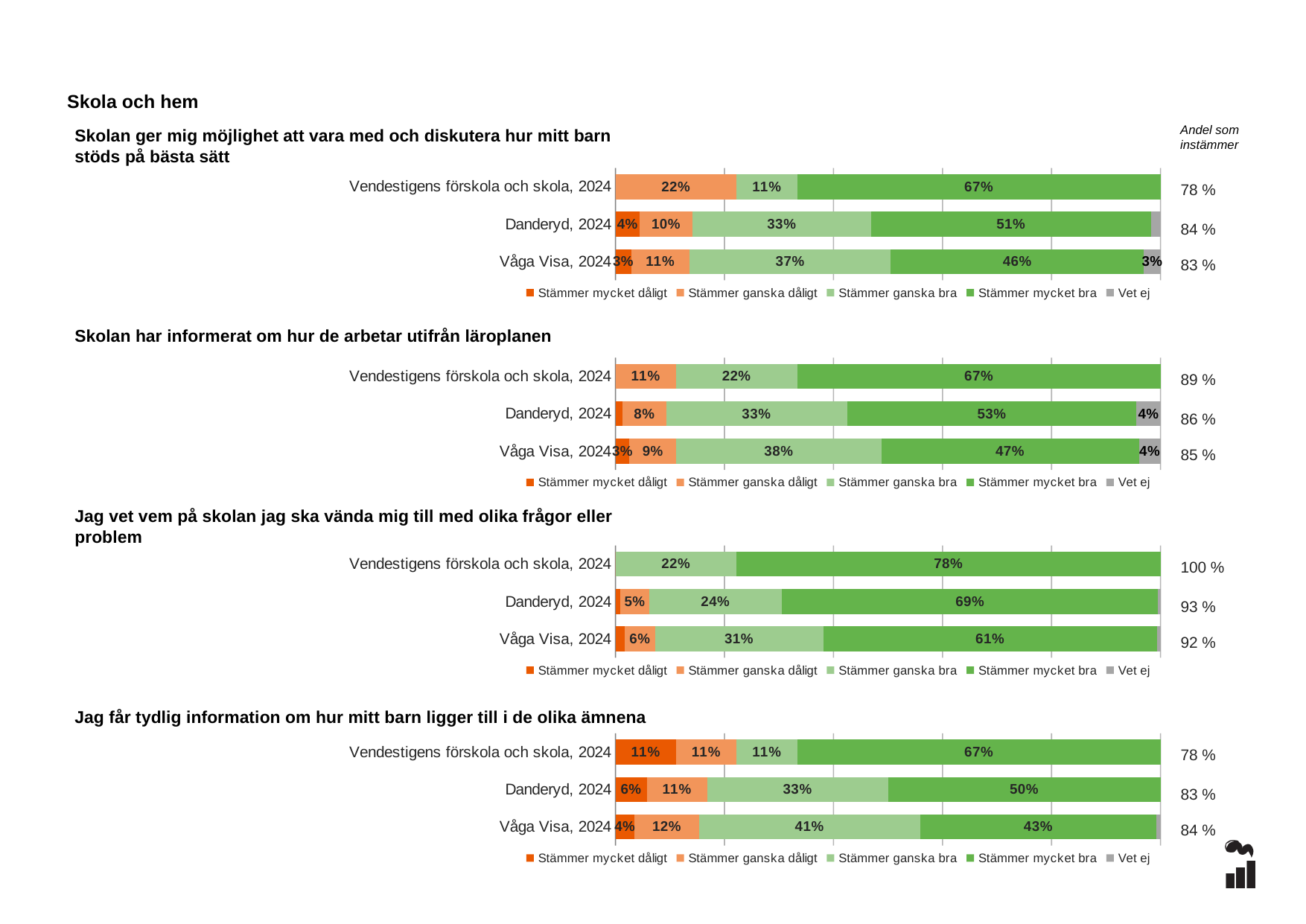
In the chart 'Jag får tydlig information om hur mitt barn ligger till i de olika ämnena', which is larger: the 'Stämmer ganska bra' value for Danderyd, 2024 or for Våga Visa, 2024? Våga Visa, 2024 In the chart 'Skolan ger mig möjlighet att vara med och diskutera hur mitt barn stöds på bästa sätt', what is the 'Stämmer ganska bra' value for Danderyd, 2024? 33% In the chart 'Jag får tydlig information om hur mitt barn ligger till i de olika ämnena', what is the 'Stämmer mycket dåligt' value for Vendestigens förskola och skola, 2024? 11% How many categories (bars) are shown in the chart 'Skolan ger mig möjlighet att vara med och diskutera hur mitt barn stöds på bästa sätt'? 3 In the chart 'Jag vet vem på skolan jag ska vända mig till med olika frågor eller problem', which category has the lowest 'Andel som instämmer'? Våga Visa, 2024 In the chart 'Skolan har informerat om hur de arbetar utifrån läroplanen', what is the 'Stämmer mycket bra' value for Våga Visa, 2024? 47% In the chart 'Jag vet vem på skolan jag ska vända mig till med olika frågor eller problem', which category has the highest 'Stämmer mycket bra' value? Vendestigens förskola och skola, 2024 In the chart 'Skolan ger mig möjlighet att vara med och diskutera hur mitt barn stöds på bästa sätt', what is the 'Stämmer mycket bra' value for Vendestigens förskola och skola, 2024? 67% In the chart 'Jag vet vem på skolan jag ska vända mig till med olika frågor eller problem', what is the difference between the 'Stämmer mycket bra' values for Vendestigens förskola och skola, 2024 and Våga Visa, 2024? 17% How many series does the legend list for the chart 'Skolan har informerat om hur de arbetar utifrån läroplanen'? 5 What kind of chart is used for 'Jag får tydlig information om hur mitt barn ligger till i de olika ämnena'? Stacked bar chart In the chart 'Skolan har informerat om hur de arbetar utifrån läroplanen', what is the 'Andel som instämmer' for Vendestigens förskola och skola, 2024? 89 %